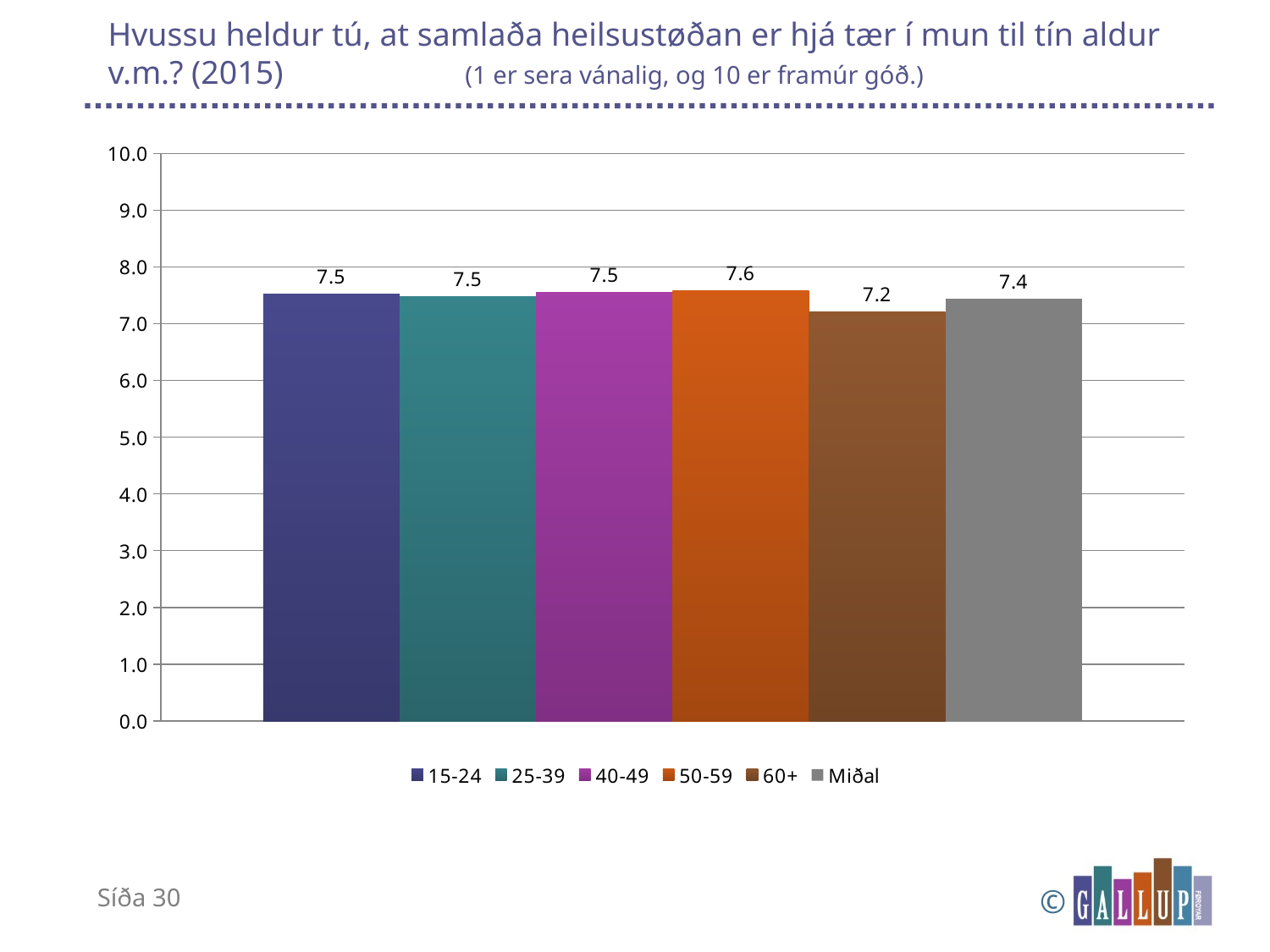
Which age group has the highest value? 50-59 What kind of chart is shown on the slide? bar chart Which category has the lowest value? 60+ What is the difference between the values for 50-59 and 60+? 0.4 How many bars are plotted on the chart? 6 Which is larger, the value for 60+ or the value for Miðal? Miðal What is the value for the 15-24 age group? 7.5 What colour is the bar for the 50-59 age group? orange What is the value for the 60+ age group? 7.2 How many entries does the legend list? 6 Is the value for 60+ greater or less than 7.0? greater What is the value for Miðal? 7.4